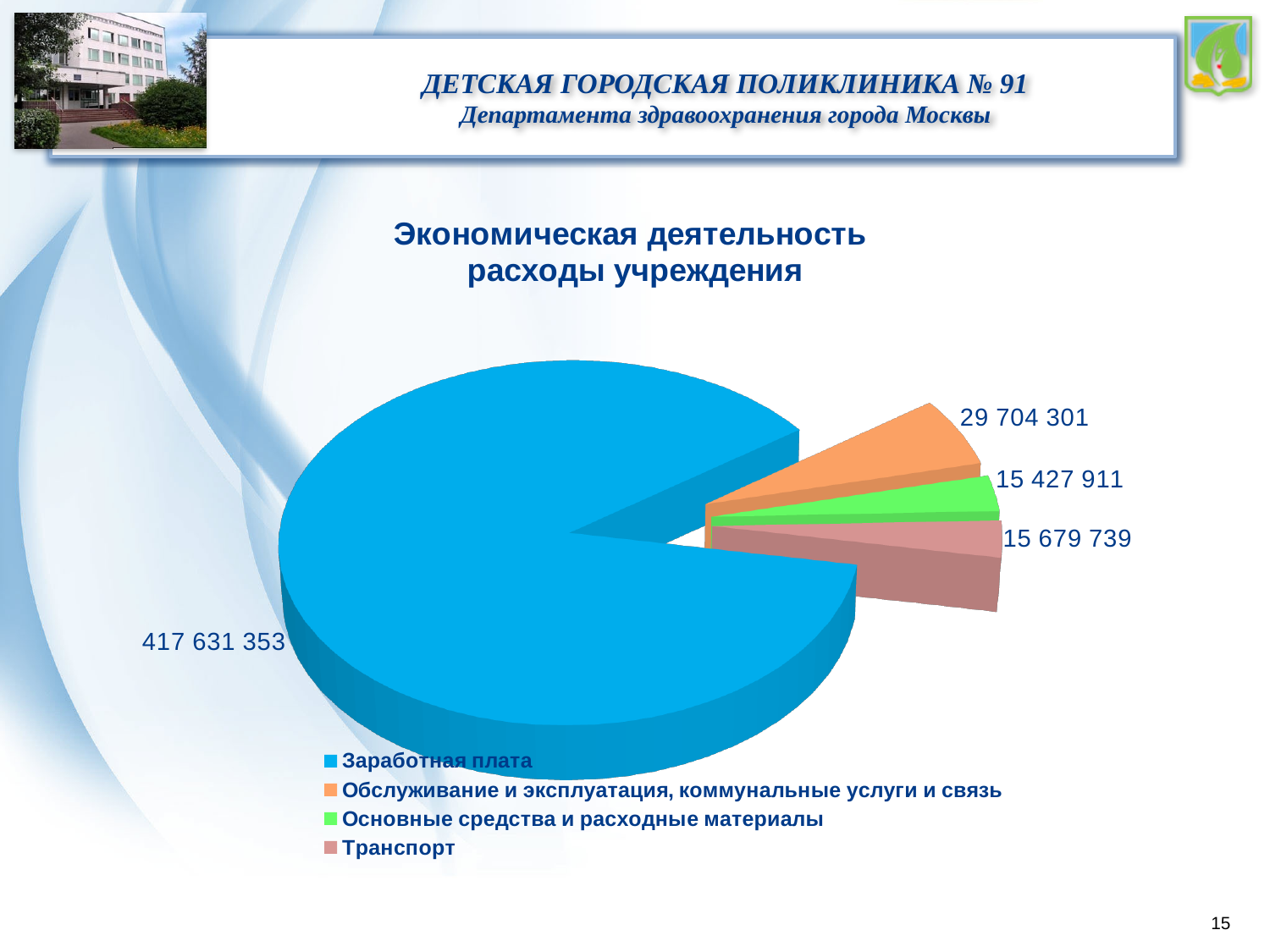
What is the value shown for Транспорт? 15 679 739 What is the value shown for Основные средства и расходные материалы? 15 427 911 What is the title of the chart? Экономическая деятельность расходы учреждения What is the value shown for Обслуживание и эксплуатация, коммунальные услуги и связь? 29 704 301 What is the value shown for Заработная плата? 417 631 353 What is the difference between the values for Транспорт and Основные средства и расходные материалы? 251 828 How many categories does the pie chart show? 4 Which category has the smallest value? Основные средства и расходные материалы Which is larger, the value for Транспорт or the value for Основные средства и расходные материалы? Транспорт What kind of chart is shown on the slide? Pie chart Which category has the largest slice of the pie? Заработная плата What is the difference between the values for Обслуживание и эксплуатация, коммунальные услуги и связь and Основные средства и расходные материалы? 14 276 390